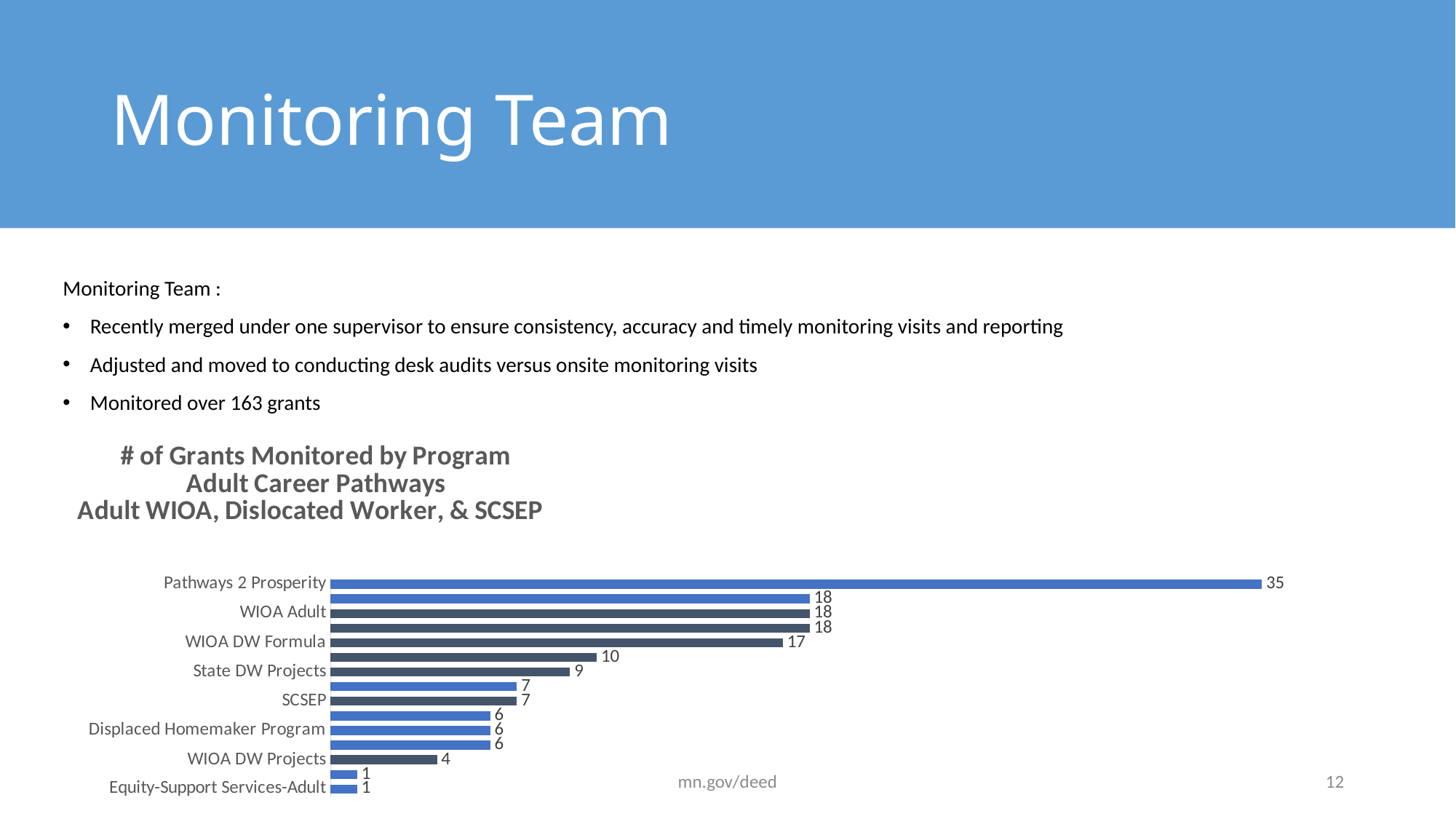
What is the value shown for WIOA DW Projects? 4 What is the difference between the values for State DW Projects and WIOA DW Projects? 5 What kind of chart is shown on the slide? bar chart How many grants were monitored for Pathways 2 Prosperity? 35 What is the title of the chart? # of Grants Monitored by Program Adult Career Pathways Adult WIOA, Dislocated Worker, & SCSEP What is the difference between the values for Pathways 2 Prosperity and WIOA DW Formula? 18 What is the value shown for State DW Projects? 9 What is the highest value shown in the chart? 35 What is the value shown for WIOA DW Formula? 17 What is the value shown for Equity-Support Services-Adult? 1 Which is larger, the value for WIOA DW Formula or the value for SCSEP? WIOA DW Formula Which program has the highest number of grants monitored? Pathways 2 Prosperity